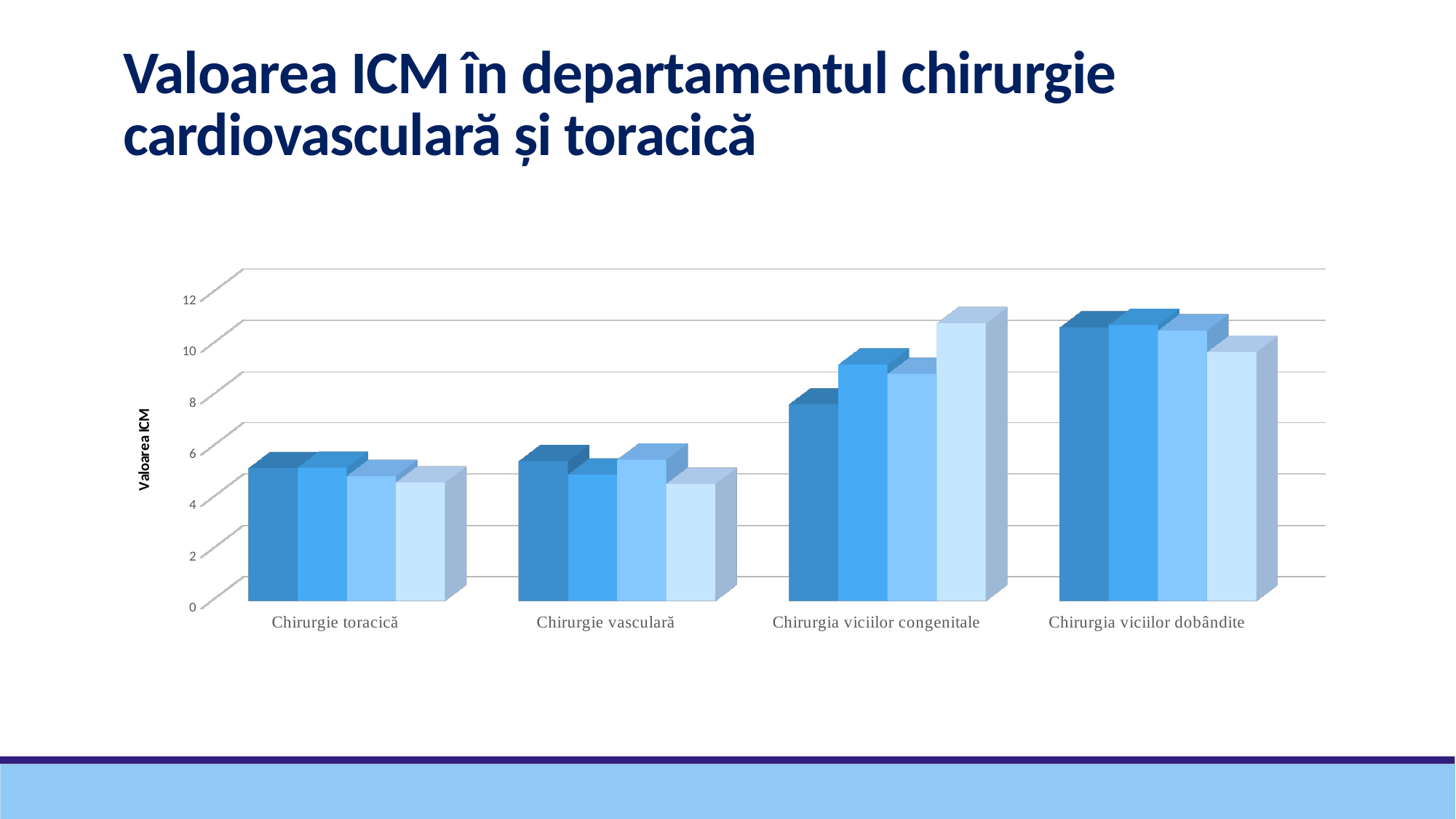
Do the darkest-blue bars generally rise or fall from left to right across the categories? rise Which has the larger darkest-blue bar: Chirurgie toracică or Chirurgia viciilor congenitale? Chirurgia viciilor congenitale Is the value of the darkest-blue bar for Chirurgia viciilor dobândite greater or less than 8? greater How many categories are shown on the x axis of the chart? 4 What is the title of the vertical axis of the chart? Valoarea ICM What is the title of the slide containing the chart? Valoarea ICM în departamentul chirurgie cardiovasculară și toracică Which category has the highest darkest-blue bar in the chart? Chirurgia viciilor dobândite Is the value of the darkest-blue bar for Chirurgie toracică greater or less than 6? less How many bars are plotted for each category in the chart? 4 Is the value of the lightest-blue bar for Chirurgia viciilor congenitale greater or less than 8? greater What kind of chart is shown on the slide? bar chart